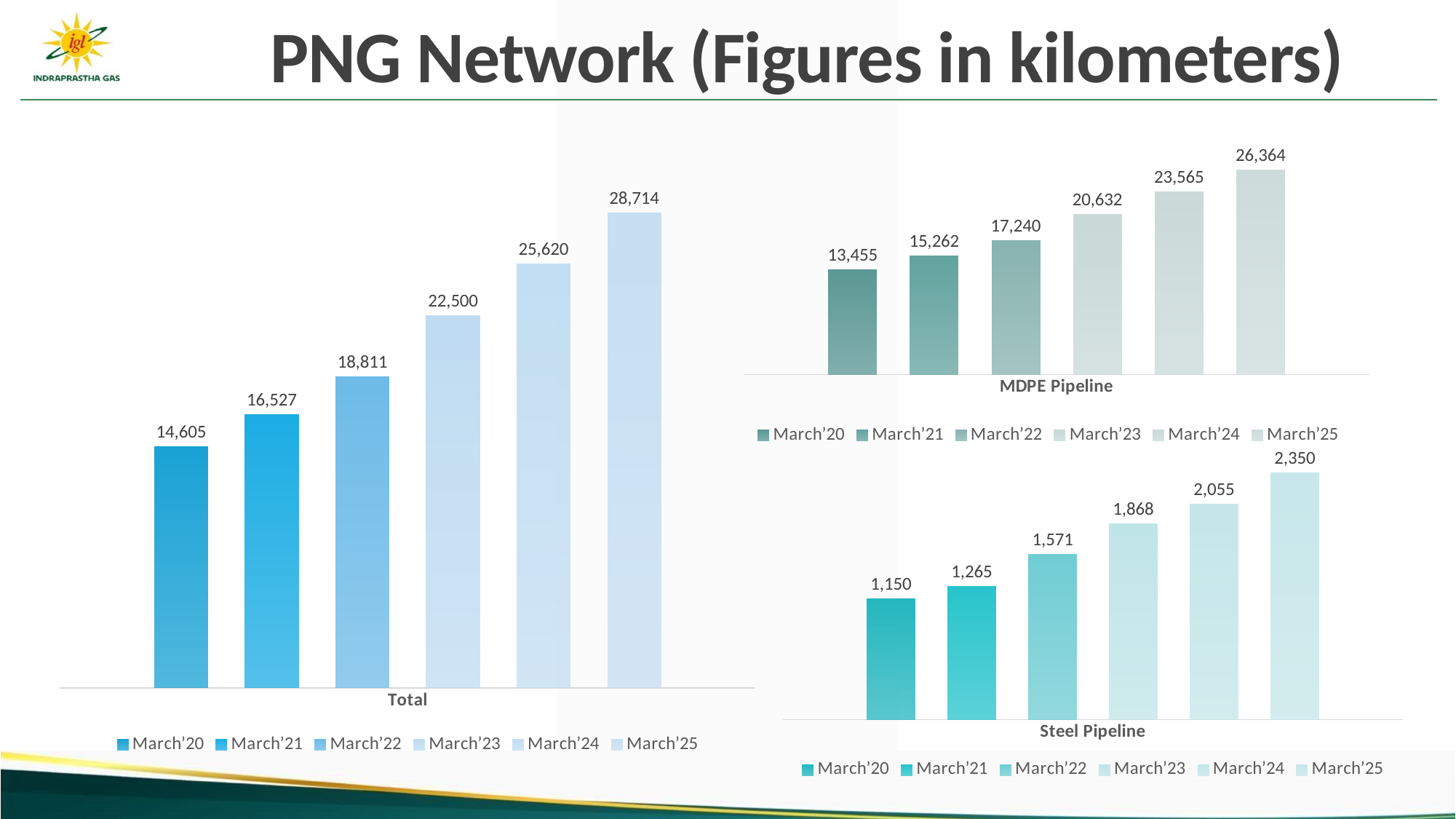
In the Steel Pipeline chart, what is the value for March'23? 1,868 How many series does the legend of the Total chart list? 6 How many bars are shown in the Steel Pipeline chart? 6 In the Steel Pipeline chart, do the values rise or fall from March'20 to March'25? Rise In the Total chart, which year has the lowest value? March'20 In the MDPE Pipeline chart, which year has the highest value? March'25 In the MDPE Pipeline chart, what is the value for March'22? 17,240 In the MDPE Pipeline chart, which is larger, the value for March'21 or March'23? March'23 In the Steel Pipeline chart, what is the difference between the March'25 and March'20 values? 1,200 In the Total chart, what is the value for March'25? 28,714 In the Total chart, what is the difference between the March'24 and March'23 values? 3,120 What kind of chart is the MDPE Pipeline chart? Bar chart